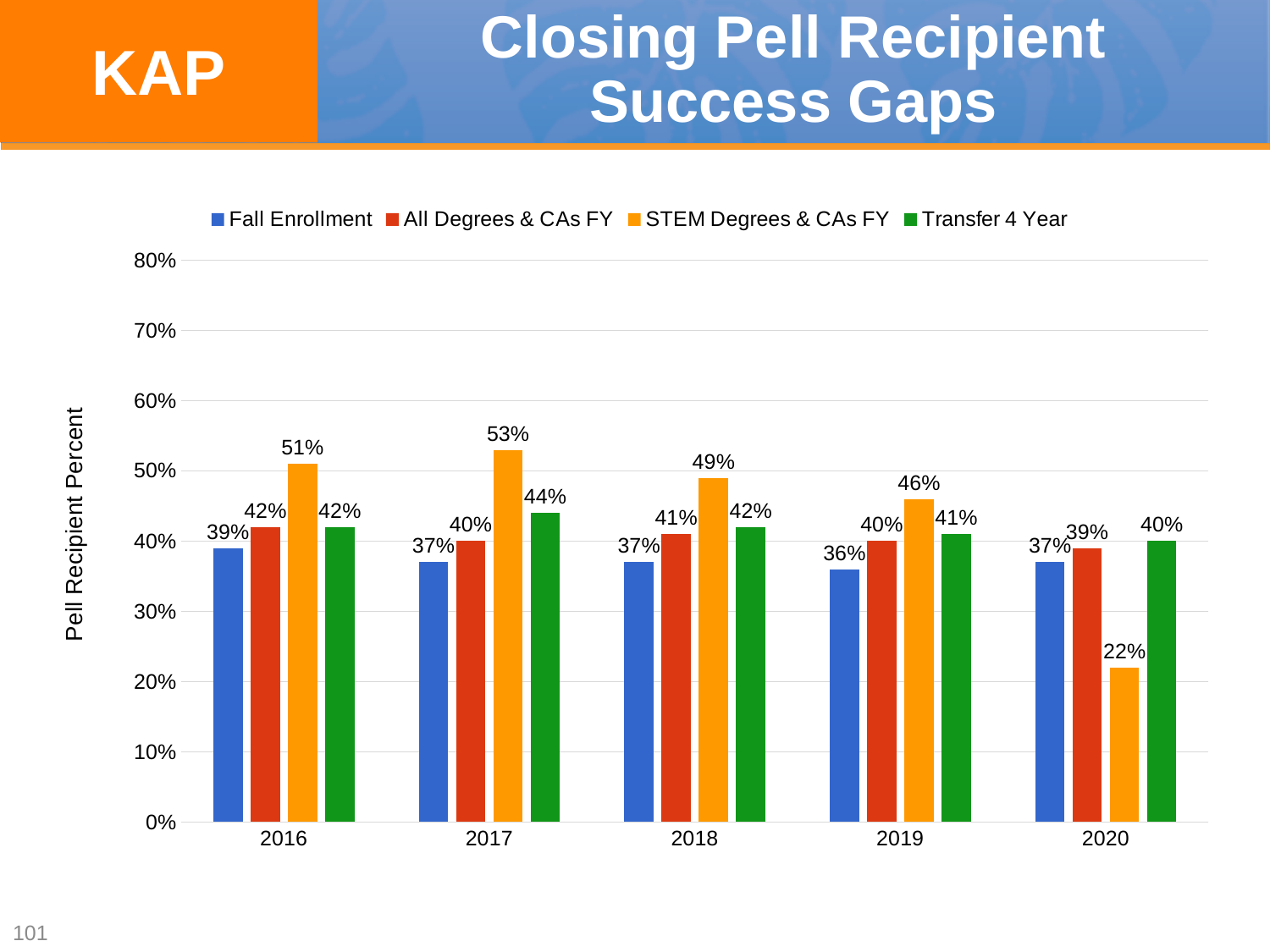
Is the STEM Degrees & CAs FY value for 2018 greater or less than 40%? greater How many years are shown on the x axis? 5 In which year is the STEM Degrees & CAs FY value highest? 2017 In which year is the STEM Degrees & CAs FY value lowest? 2020 How many series does the legend list? 4 Which is larger in 2020: the All Degrees & CAs FY value or the STEM Degrees & CAs FY value? All Degrees & CAs FY What kind of chart is shown on the slide? Bar chart What is the Fall Enrollment value for 2019? 36% What is the STEM Degrees & CAs FY value for 2017? 53% What is the difference between the STEM Degrees & CAs FY value and the Fall Enrollment value in 2016? 12% What is the Transfer 4 Year value for 2020? 40% What is the All Degrees & CAs FY value for 2018? 41%